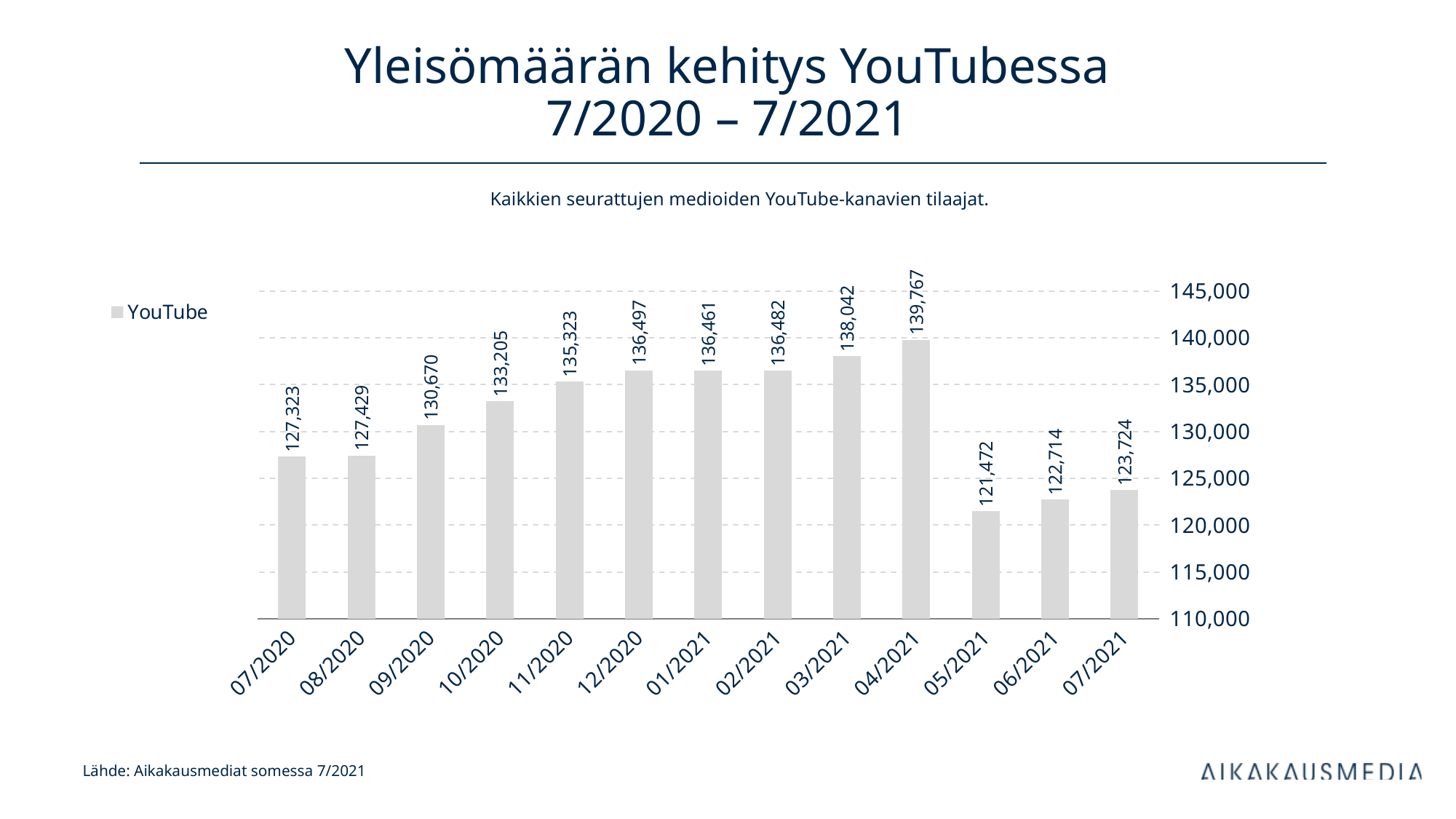
How many series does the legend list? 1 What is the difference between the values for 04/2021 and 05/2021? 18,295 What is the value for 07/2020? 127,323 What kind of chart is shown on the slide? bar chart What is the value for 04/2021? 139,767 Which month has the highest value? 04/2021 How many months are shown on the x axis? 13 What is the value for 05/2021? 121,472 Which month has the lowest value? 05/2021 Is the value for 03/2021 greater or less than 135,000? greater Do the values rise or fall from 07/2020 to 04/2021? rise Which is larger, the value for 09/2020 or the value for 07/2021? 09/2020